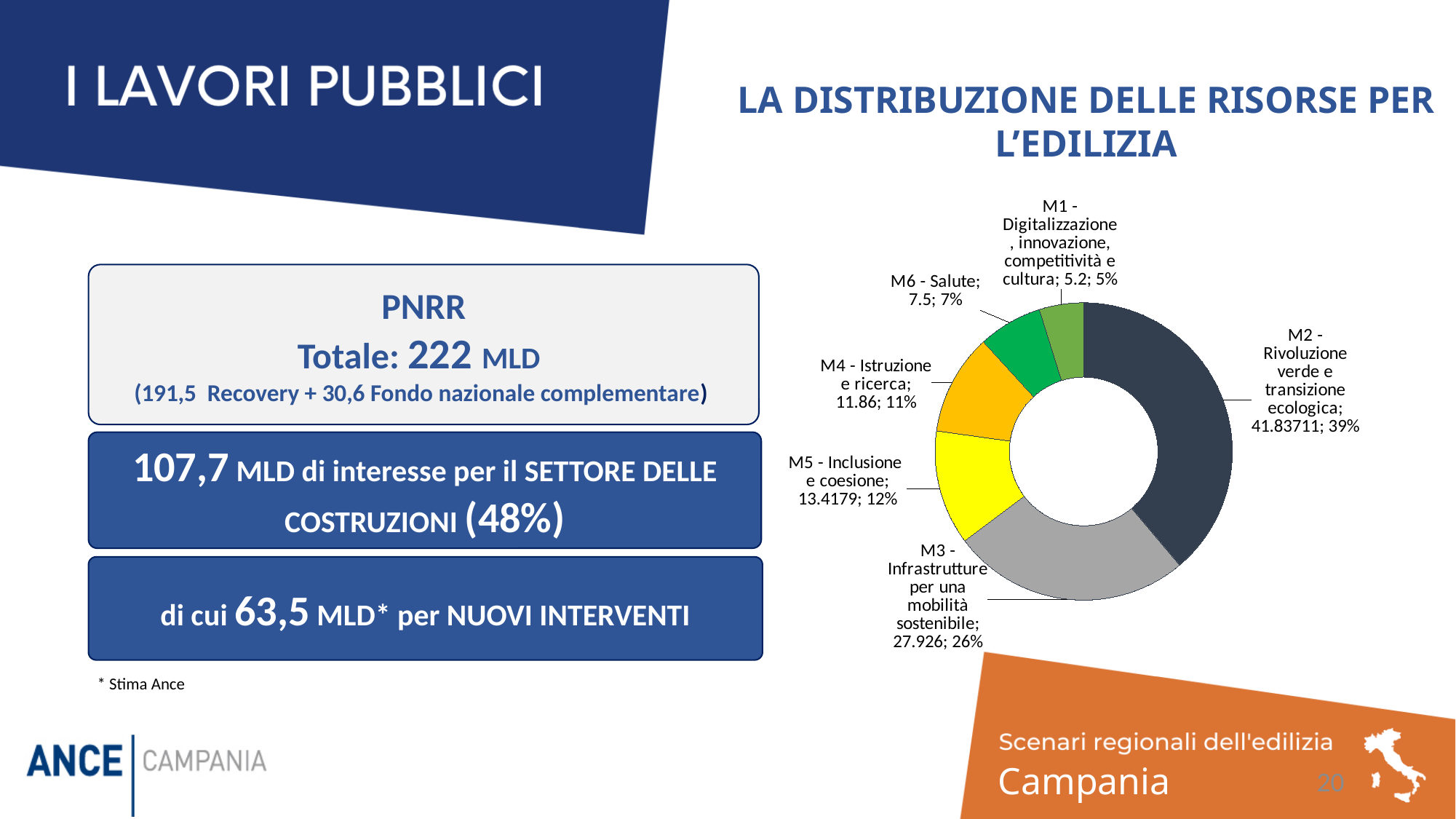
What is the difference in percentage points between M2 (39%) and M3 (26%)? 13% Which slice is the smallest? M1 - Digitalizzazione, innovazione, competitività e cultura What value is shown for M5 - Inclusione e coesione? 13.4179 What percentage is shown for M4 - Istruzione e ricerca? 11% How many slices does the chart have? 6 What is the title of the chart? LA DISTRIBUZIONE DELLE RISORSE PER L'EDILIZIA What value is shown for M6 - Salute? 7.5 Which slice is the largest? M2 - Rivoluzione verde e transizione ecologica What kind of chart is shown on the slide? doughnut chart Which is larger, the slice for M5 - Inclusione e coesione or the slice for M6 - Salute? M5 - Inclusione e coesione What share of the chart does M3 - Infrastrutture per una mobilità sostenibile represent? 26% What value is shown for M2 - Rivoluzione verde e transizione ecologica? 41.83711